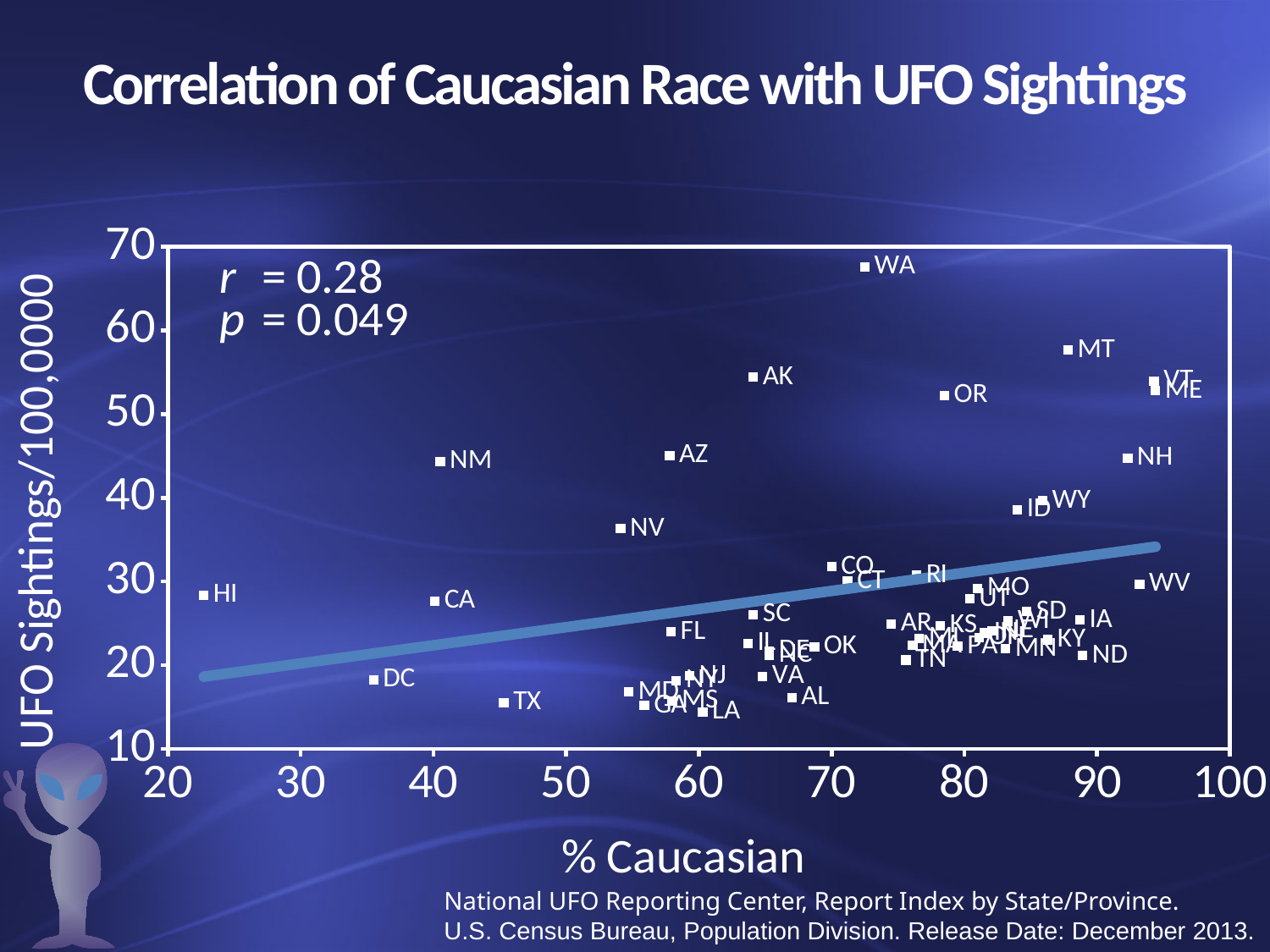
Which has more UFO sightings per 100,000, WA or MT? WA Which state has the highest UFO sightings per 100,000 on the chart? WA What kind of chart is shown on the slide? scatter plot According to the trend line, do UFO sightings rise or fall as % Caucasian increases? rise Is the UFO sightings value for NM greater or less than 40? greater Is the % Caucasian value for HI greater or less than 30? less What correlation coefficient r is printed on the chart? 0.28 Is the UFO sightings value for WA greater or less than 60? greater Which has more UFO sightings per 100,000, NM or NV? NM What is the label of the x axis? % Caucasian Which state has the lowest % Caucasian on the chart? HI